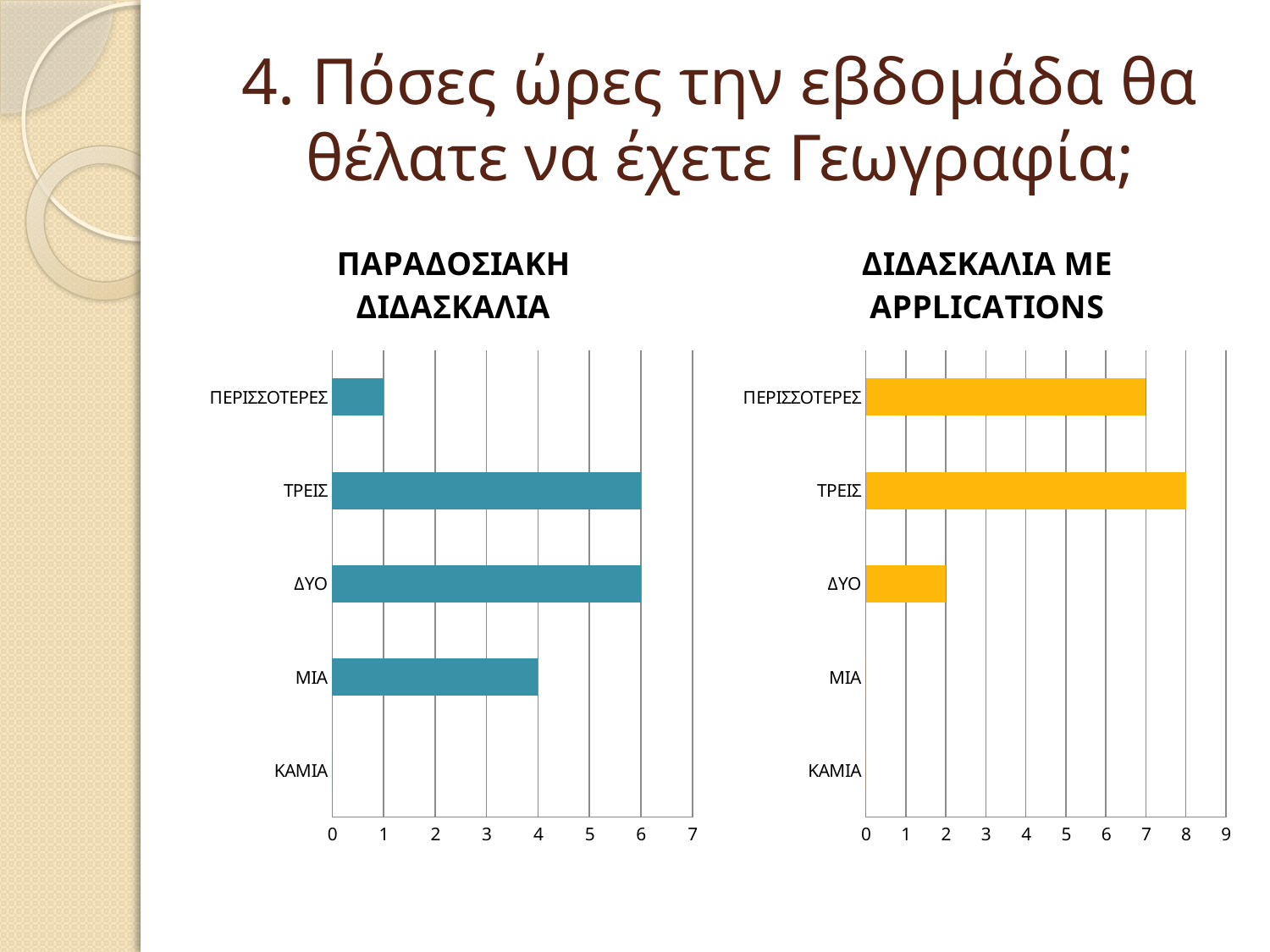
In the ΔΙΔΑΣΚΑΛΙΑ ΜΕ APPLICATIONS chart, what is the difference between the values for ΤΡΕΙΣ and ΠΕΡΙΣΣΟΤΕΡΕΣ? 1 In the ΠΑΡΑΔΟΣΙΑΚΗ ΔΙΔΑΣΚΑΛΙΑ chart, what is the value for ΜΙΑ? 4 In the ΠΑΡΑΔΟΣΙΑΚΗ ΔΙΔΑΣΚΑΛΙΑ chart, which category has the lowest value? ΚΑΜΙΑ In the ΔΙΔΑΣΚΑΛΙΑ ΜΕ APPLICATIONS chart, which is larger, the value for ΠΕΡΙΣΣΟΤΕΡΕΣ or the value for ΔΥΟ? ΠΕΡΙΣΣΟΤΕΡΕΣ What kind of chart is the ΔΙΔΑΣΚΑΛΙΑ ΜΕ APPLICATIONS chart? Bar chart In the ΠΑΡΑΔΟΣΙΑΚΗ ΔΙΔΑΣΚΑΛΙΑ chart, what is the value for ΠΕΡΙΣΣΟΤΕΡΕΣ? 1 In the ΔΙΔΑΣΚΑΛΙΑ ΜΕ APPLICATIONS chart, which category has the highest value? ΤΡΕΙΣ In the ΔΙΔΑΣΚΑΛΙΑ ΜΕ APPLICATIONS chart, what is the value for ΔΥΟ? 2 In the ΠΑΡΑΔΟΣΙΑΚΗ ΔΙΔΑΣΚΑΛΙΑ chart, which is larger, the value for ΜΙΑ or the value for ΠΕΡΙΣΣΟΤΕΡΕΣ? ΜΙΑ In the ΠΑΡΑΔΟΣΙΑΚΗ ΔΙΔΑΣΚΑΛΙΑ chart, what is the difference between the values for ΤΡΕΙΣ and ΜΙΑ? 2 In the ΔΙΔΑΣΚΑΛΙΑ ΜΕ APPLICATIONS chart, what is the value for ΤΡΕΙΣ? 8 How many categories does the ΠΑΡΑΔΟΣΙΑΚΗ ΔΙΔΑΣΚΑΛΙΑ chart show? 5